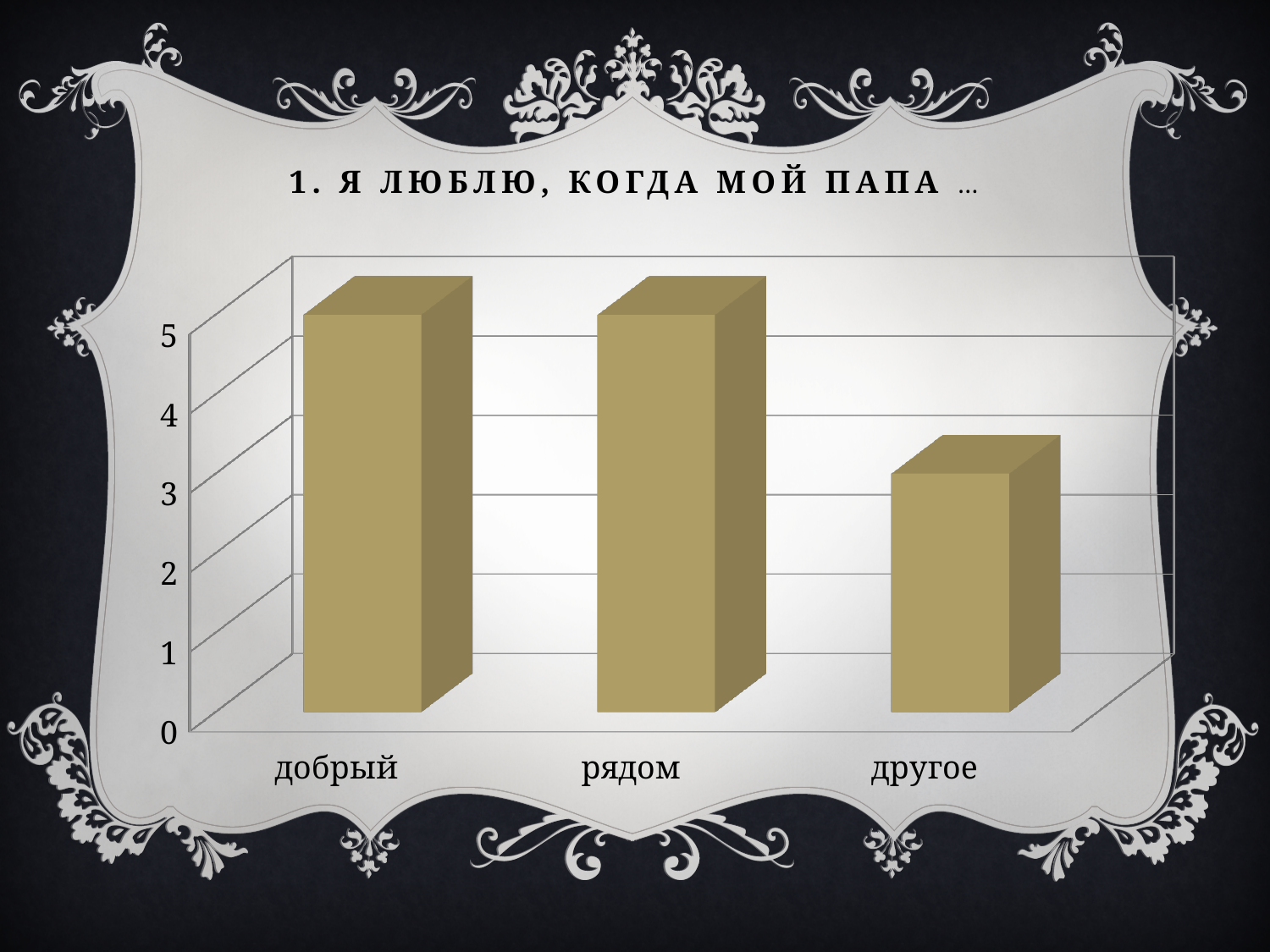
Is the value for добрый greater or less than 4? greater What is the title of the chart? 1. Я ЛЮБЛЮ, КОГДА МОЙ ПАПА … What kind of chart is shown on the slide? bar chart Is the value for другое greater or less than 2? greater Is the value for другое greater or less than 4? less Which is larger, the value for рядом or the value for другое? рядом Which is larger, the value for добрый or the value for другое? добрый What is the highest value shown on the y axis of the chart? 5 How many categories are shown on the x axis of the chart? 3 Which category has the lowest bar in the chart? другое